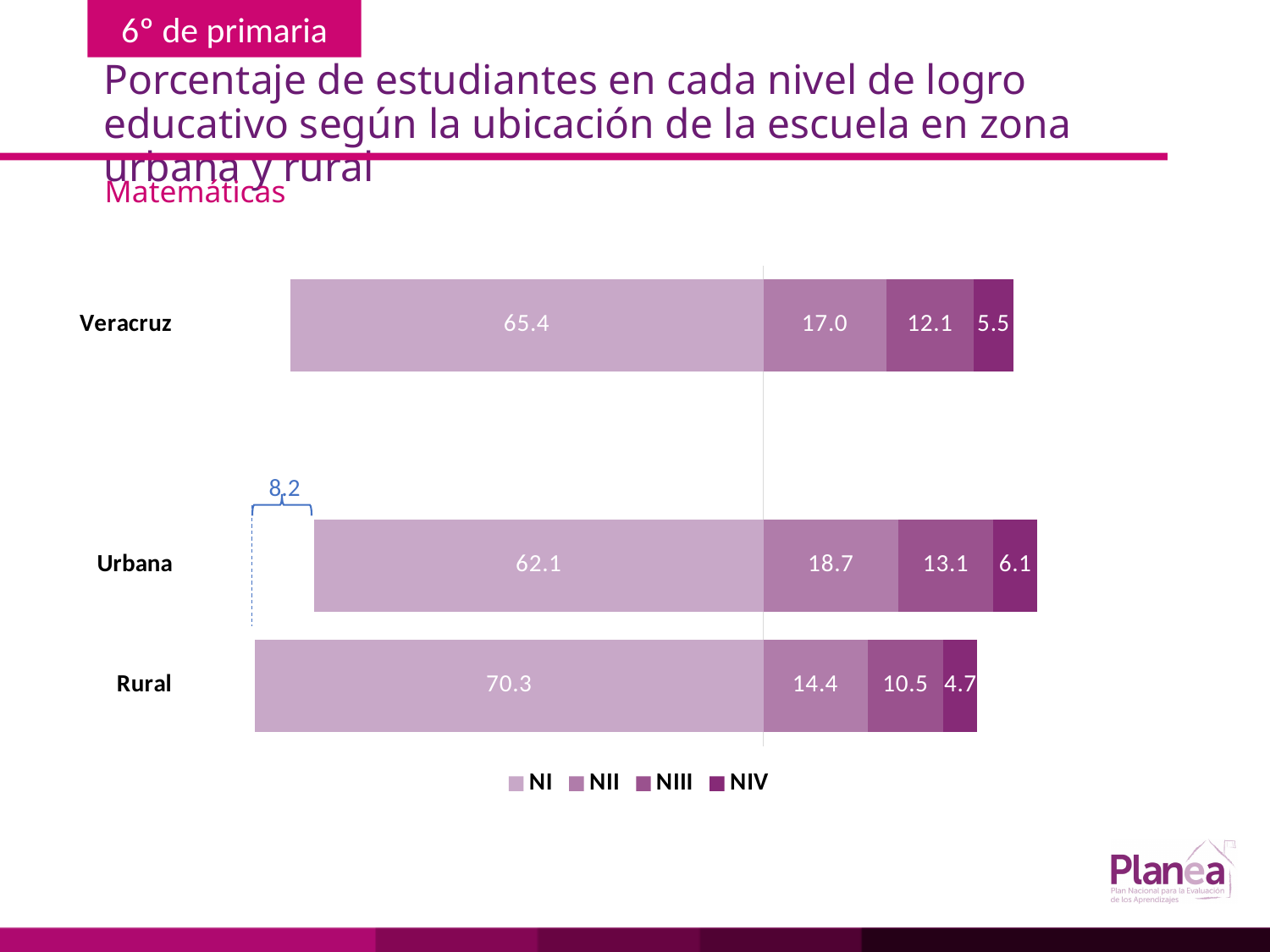
What is the difference between the NI values for Rural and Urbana? 8.2 What is the NI value for Rural? 70.3 What is the NIV value for Veracruz? 5.5 Which category has the lowest NIV value? Rural How many series does the legend list? 4 What is the NII value for Urbana? 18.7 What kind of chart is shown on the slide? Stacked bar chart Which category has the highest NI value? Rural What is the NIII value for Rural? 10.5 What is the total of the stacked bar for Urbana? 100.0 How many categories are shown on the chart? 3 Which is larger, the NIII value for Urbana or for Veracruz? Urbana